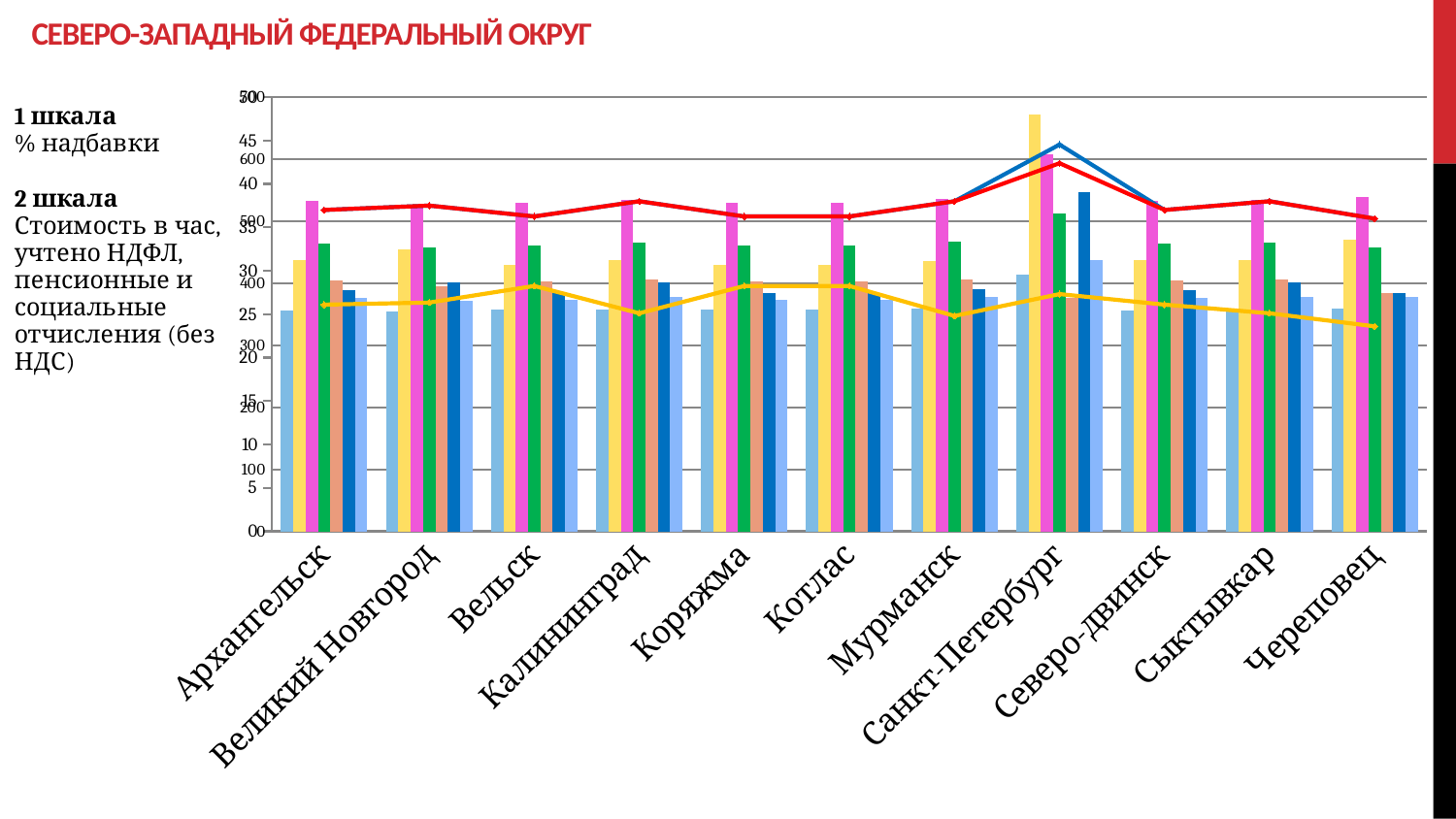
Which city has the tallest bar in the chart? Санкт-Петербург Which city is the first category on the x axis? Архангельск Is the tallest bar for Санкт-Петербург taller than the tallest bar for Мурманск? Yes, Санкт-Петербург At which city does the red line reach its highest point? Санкт-Петербург At which city does the blue line reach its highest point? Санкт-Петербург What is the title of the slide containing the chart? СЕВЕРО-ЗАПАДНЫЙ ФЕДЕРАЛЬНЫЙ ОКРУГ Which city is the last category on the x axis? Череповец How many cities are shown along the x axis of the chart? 11 Does the blue line rise or fall between Мурманск and Санкт-Петербург? Rise Does the red line rise or fall between Санкт-Петербург and Северо-двинск? Fall What kind of chart is shown on the slide? A combined bar and line chart